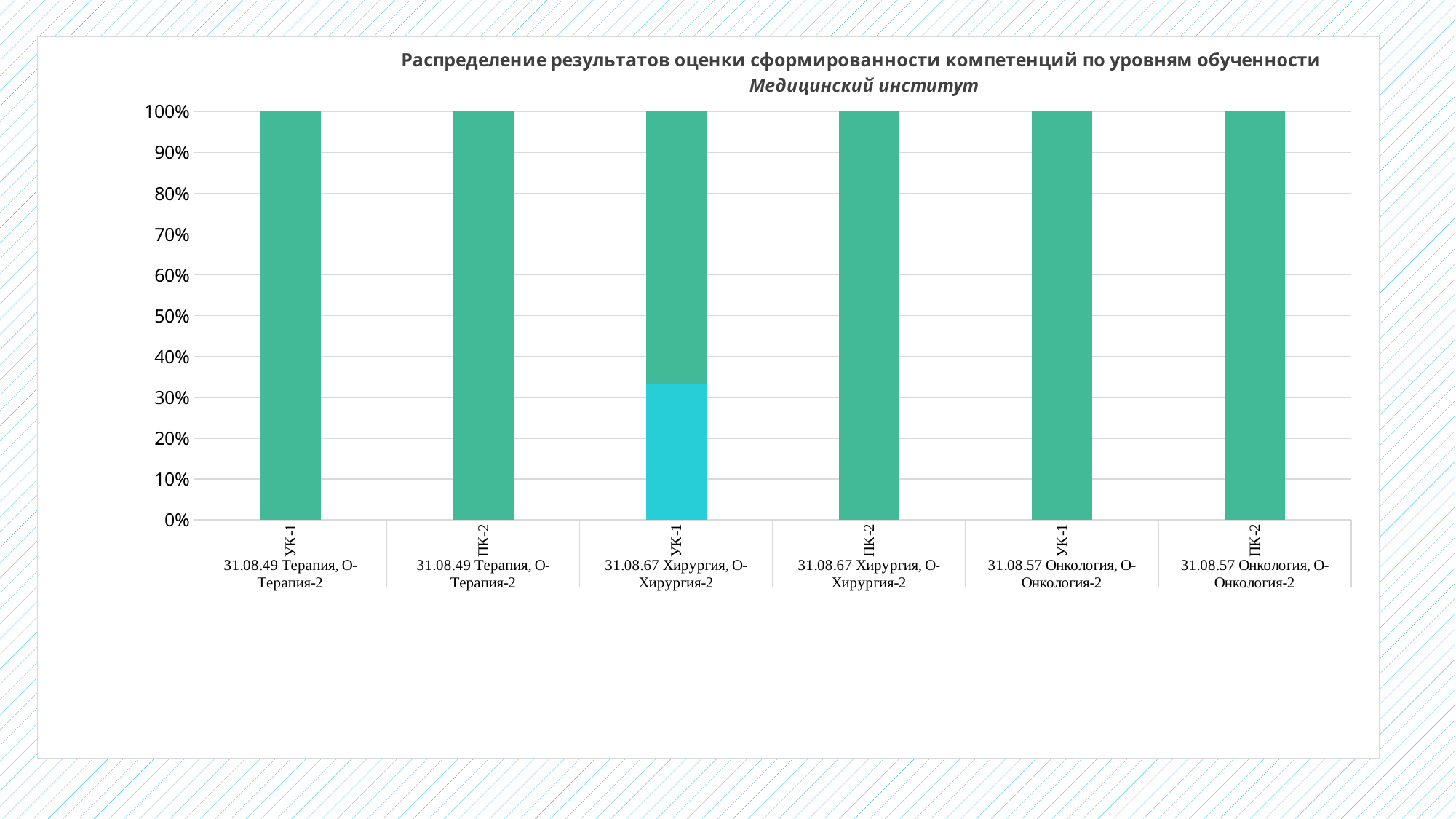
What is the subtitle (second line of the title) of the chart? Медицинский институт What is the highest value shown on the vertical axis? 100% Which bar is the only one that contains a light blue segment? УК-1, 31.08.67 Хирургия, О-Хирургия-2 What is the total height of the bar for УК-1 under 31.08.49 Терапия, О-Терапия-2? 100% Is the light blue segment of the bar for УК-1 under 31.08.67 Хирургия, О-Хирургия-2 greater or less than 20%? greater How many bars (categories) are plotted in the chart? 6 How many bars consist entirely of the green colour? 5 Is the light blue segment of the bar for УК-1 under 31.08.67 Хирургия, О-Хирургия-2 greater or less than 40%? less What kind of chart is shown on the slide? Stacked bar chart Is the green segment of the bar for УК-1 under 31.08.67 Хирургия, О-Хирургия-2 greater or less than 50%? greater What is the total height of the bar for ПК-2 under 31.08.57 Онкология, О-Онкология-2? 100%